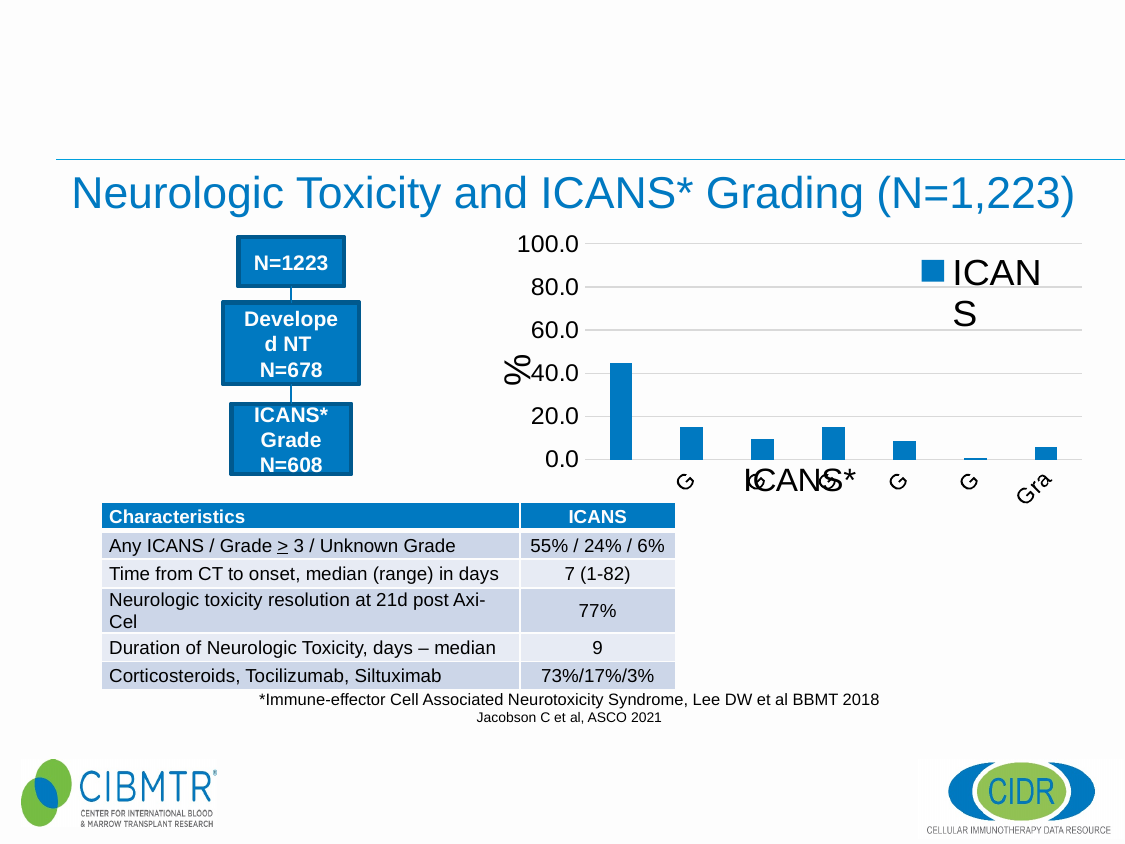
Is the value of the leftmost bar in the chart greater or less than 60.0? less What is the label on the vertical axis of the chart? % How many bars are plotted in the chart? 7 Which bar in the chart is the lowest? the sixth bar from the left What kind of chart is shown on the slide? bar chart Is the value of the leftmost bar in the chart greater or less than 20.0? greater Which bar in the chart is the highest? the leftmost (first) bar What is the name of the series shown in the chart legend? ICANS What is the highest value shown on the vertical axis of the chart? 100.0 How many series does the chart legend list? 1 Which is larger in the chart, the leftmost bar or the second bar from the left? the leftmost bar Is the value of the second bar from the left in the chart greater or less than 20.0? less